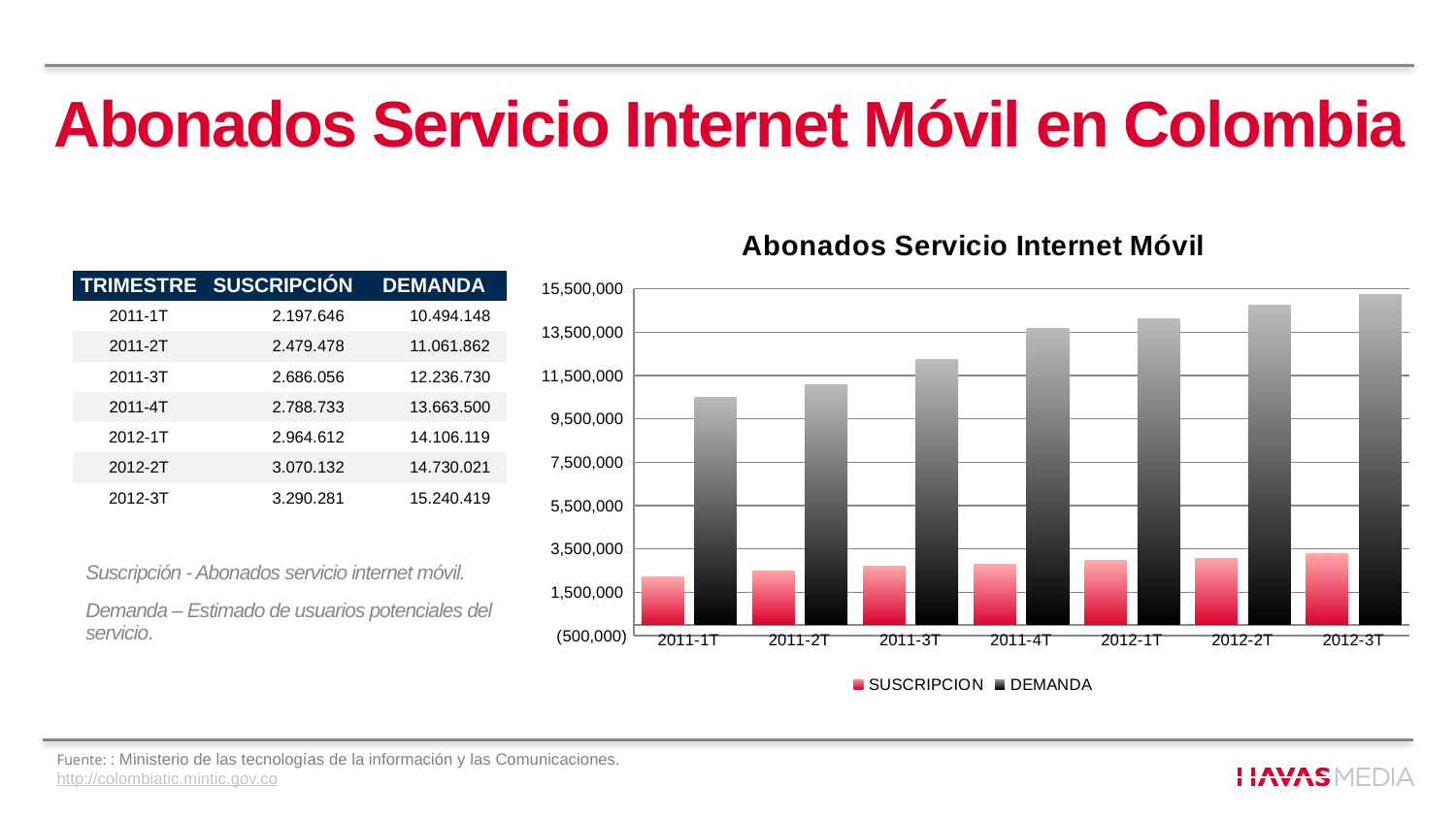
Is the DEMANDA value for 2012-3T greater or less than 13,500,000? greater In which quarter is the SUSCRIPCION bar lowest? 2011-1T What is the title of the chart? Abonados Servicio Internet Móvil According to the table on the slide, what is the DEMANDA value for 2011-4T? 13.663.500 How many quarters (categories) are plotted on the x axis of the chart? 7 What kind of chart is shown on the slide? bar chart In which quarter is the DEMANDA bar highest? 2012-3T Is the DEMANDA value for 2011-1T greater or less than 11,500,000? less Using the table values, by how much did DEMANDA increase from 2011-1T to 2012-3T? 4.746.271 How many series does the legend of the chart list? 2 Do the DEMANDA values rise or fall from 2011-1T to 2012-3T? rise According to the table on the slide, what is the SUSCRIPCIÓN value for 2012-3T? 3.290.281